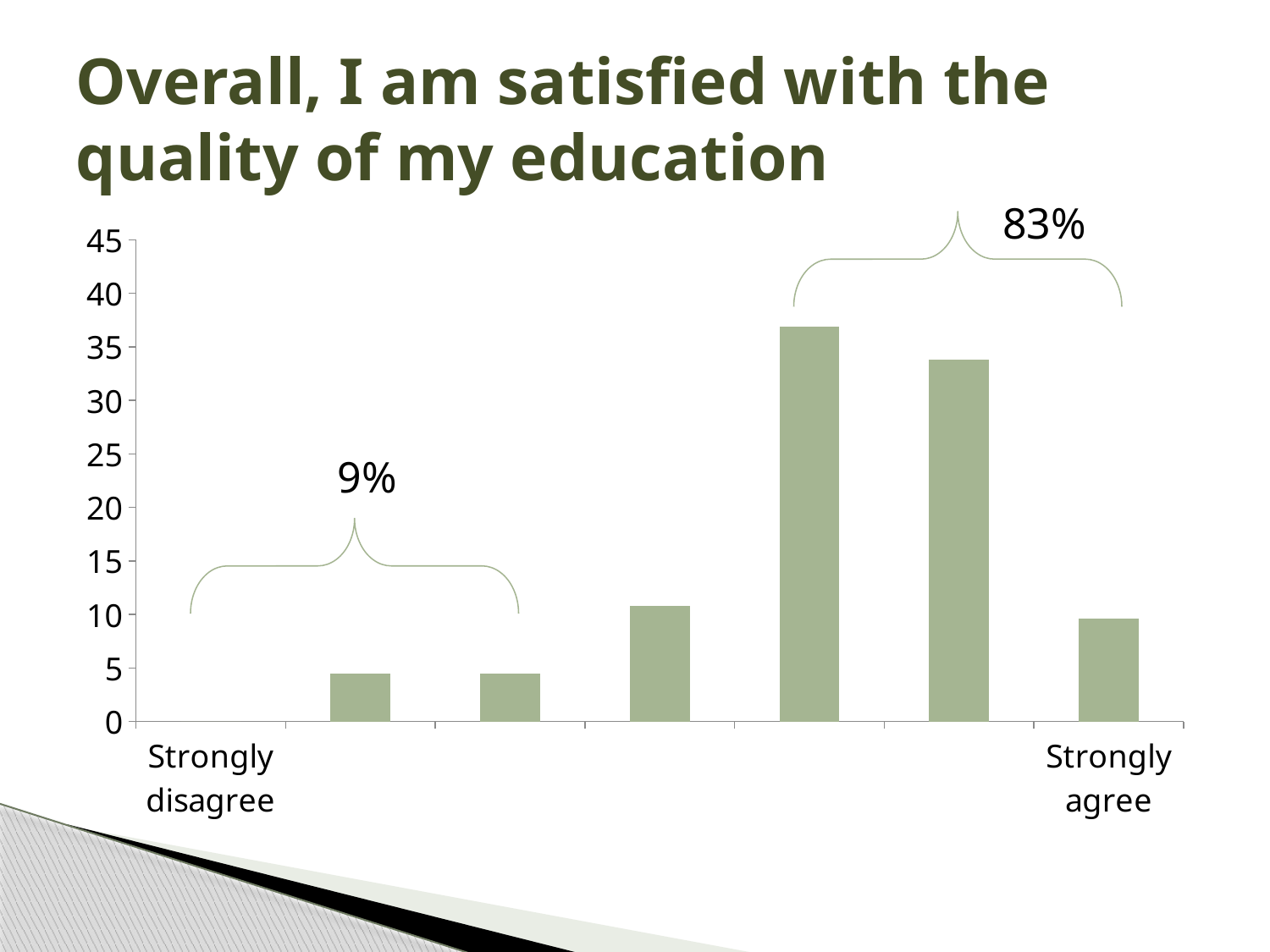
Is the value for Strongly disagree greater or less than 5? less What is the highest value shown on the vertical axis? 45 What percentage is shown by the bracket over the bars on the right (agree) side of the chart? 83% What kind of chart is shown on the slide? bar chart Which end of the scale, Strongly disagree or Strongly agree, has the taller bar? Strongly agree What is the title of the chart on the slide? Overall, I am satisfied with the quality of my education Is the value for Strongly agree greater or less than 5? greater Is the value for Strongly agree greater or less than 15? less Which is larger, the value for Strongly agree or the value for Strongly disagree? Strongly agree